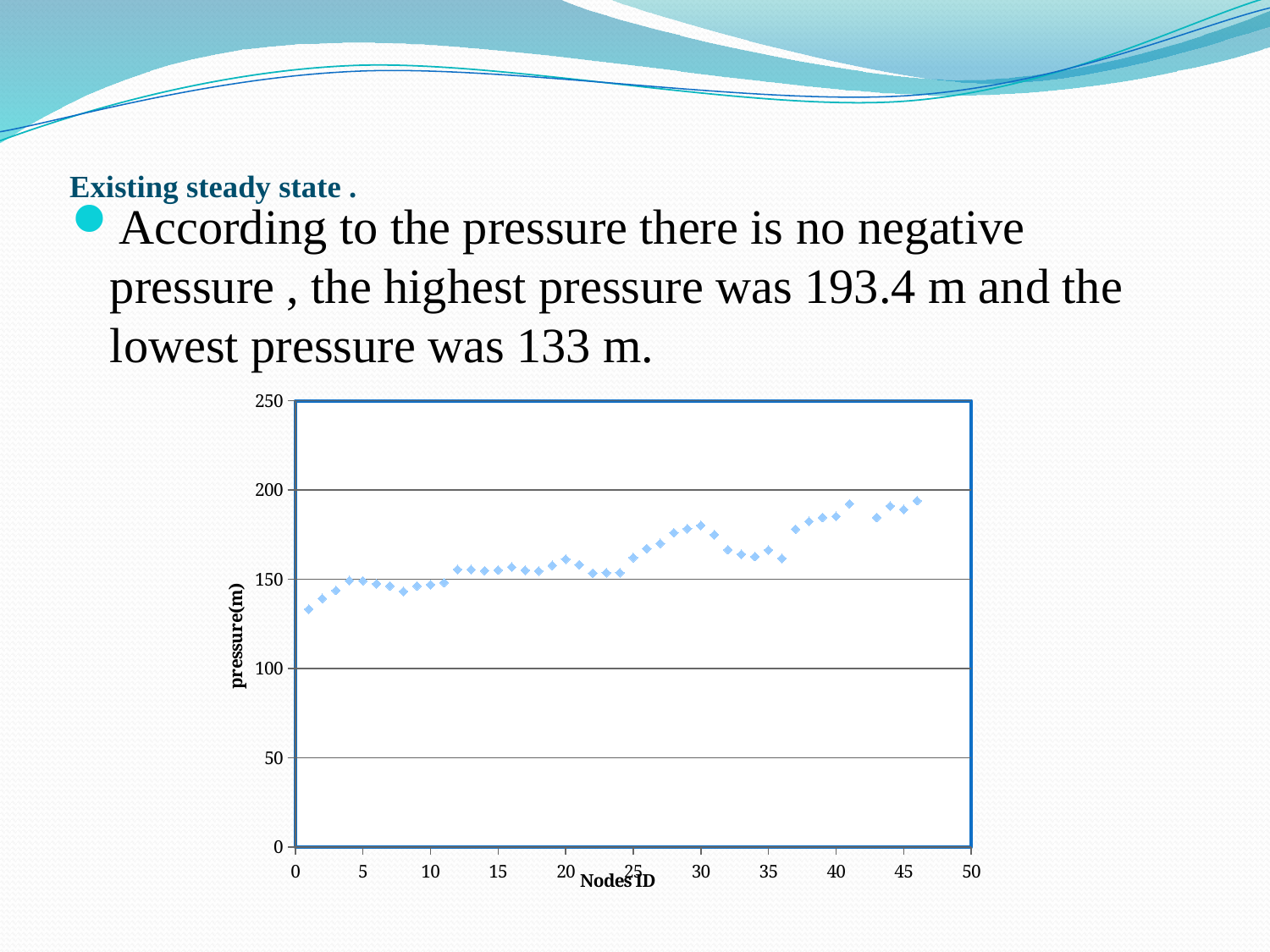
Which node ID has the lowest plotted pressure? 1 Is the pressure value at node 1 greater or less than 150? less What is the label of the vertical axis of the chart? pressure(m) What is the label of the horizontal axis of the chart? Nodes ID Are any of the plotted pressure values greater than 200? no Is the pressure value at node 46 greater or less than 200? less Which has the higher pressure, node 1 or node 46? node 46 What kind of chart is shown on the slide? scatter chart Which has the higher pressure, node 30 or node 36? node 30 Overall, do the pressure values rise or fall as the node ID increases? rise